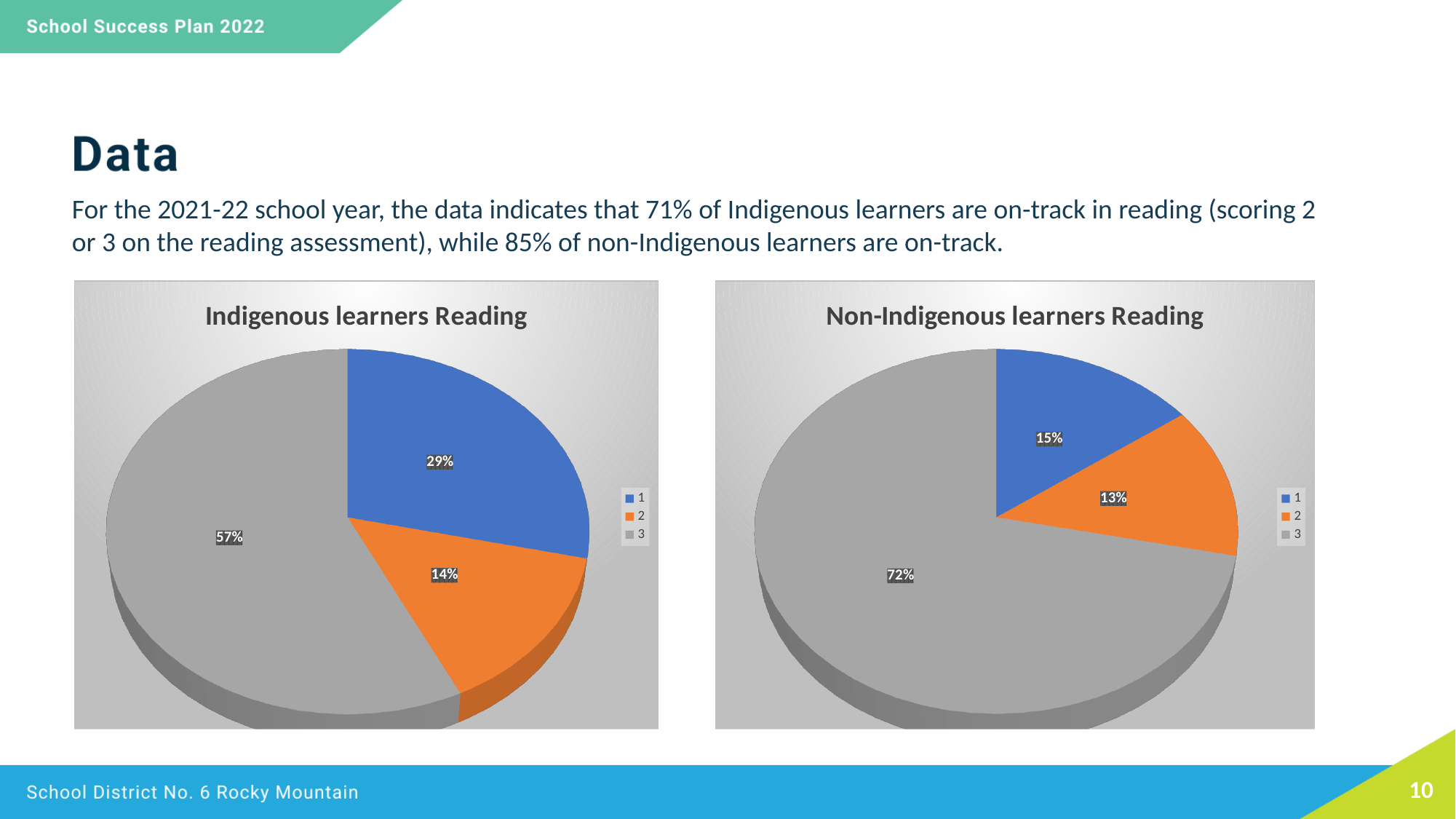
In the 'Indigenous learners Reading' chart, which category has the largest slice? 3 What kind of chart is the 'Non-Indigenous learners Reading' chart? Pie chart In the 'Indigenous learners Reading' chart, what is the difference between the shares for category 1 and category 2? 15% In the 'Indigenous learners Reading' chart, what share of the pie is category 3? 57% Which chart has the larger share for category 3, 'Indigenous learners Reading' or 'Non-Indigenous learners Reading'? Non-Indigenous learners Reading How many categories does the legend of the 'Indigenous learners Reading' chart list? 3 In the 'Non-Indigenous learners Reading' chart, what share of the pie is category 2? 13% In the 'Indigenous learners Reading' chart, what share of the pie is category 1? 29% In the 'Non-Indigenous learners Reading' chart, which category has the smallest slice? 2